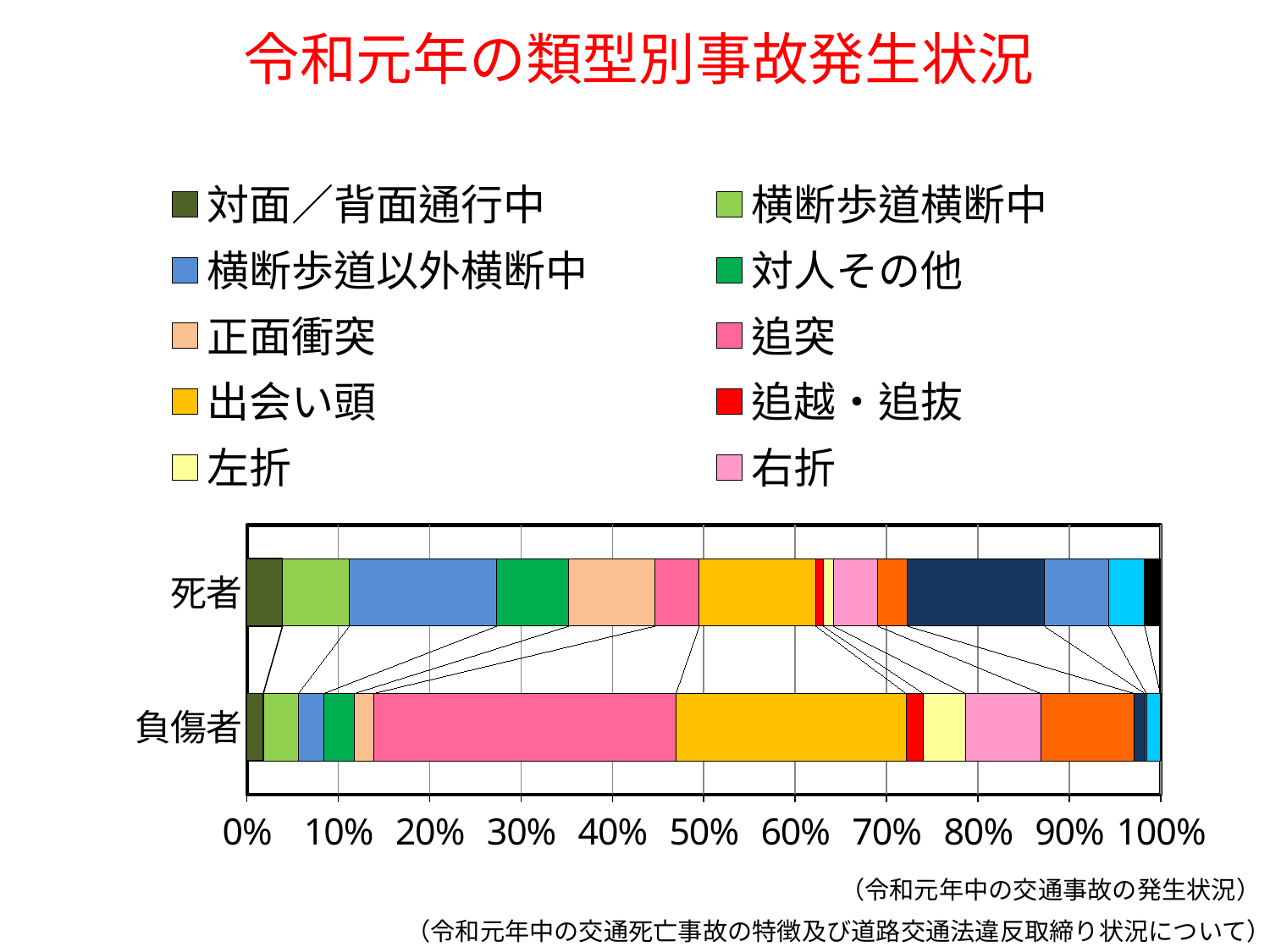
How many bars (categories) does the chart show? 2 What is the title of the slide's chart? 令和元年の類型別事故発生状況 What kind of chart is shown on the slide? Stacked bar chart Is the share of 追突 in the 死者 bar greater or less than 10%? less How many series does the legend list? 10 Which bar has the larger share for 追突, 死者 or 負傷者? 負傷者 Is the share of 対面／背面通行中 in the 死者 bar greater or less than 10%? less What colour represents 追越・追抜 in the legend? Red Which bar has the larger share for 横断歩道以外横断中, 死者 or 負傷者? 死者 Is the share of 追突 in the 負傷者 bar greater or less than 30%? greater Which legend series occupies the largest share of the 負傷者 bar? 追突